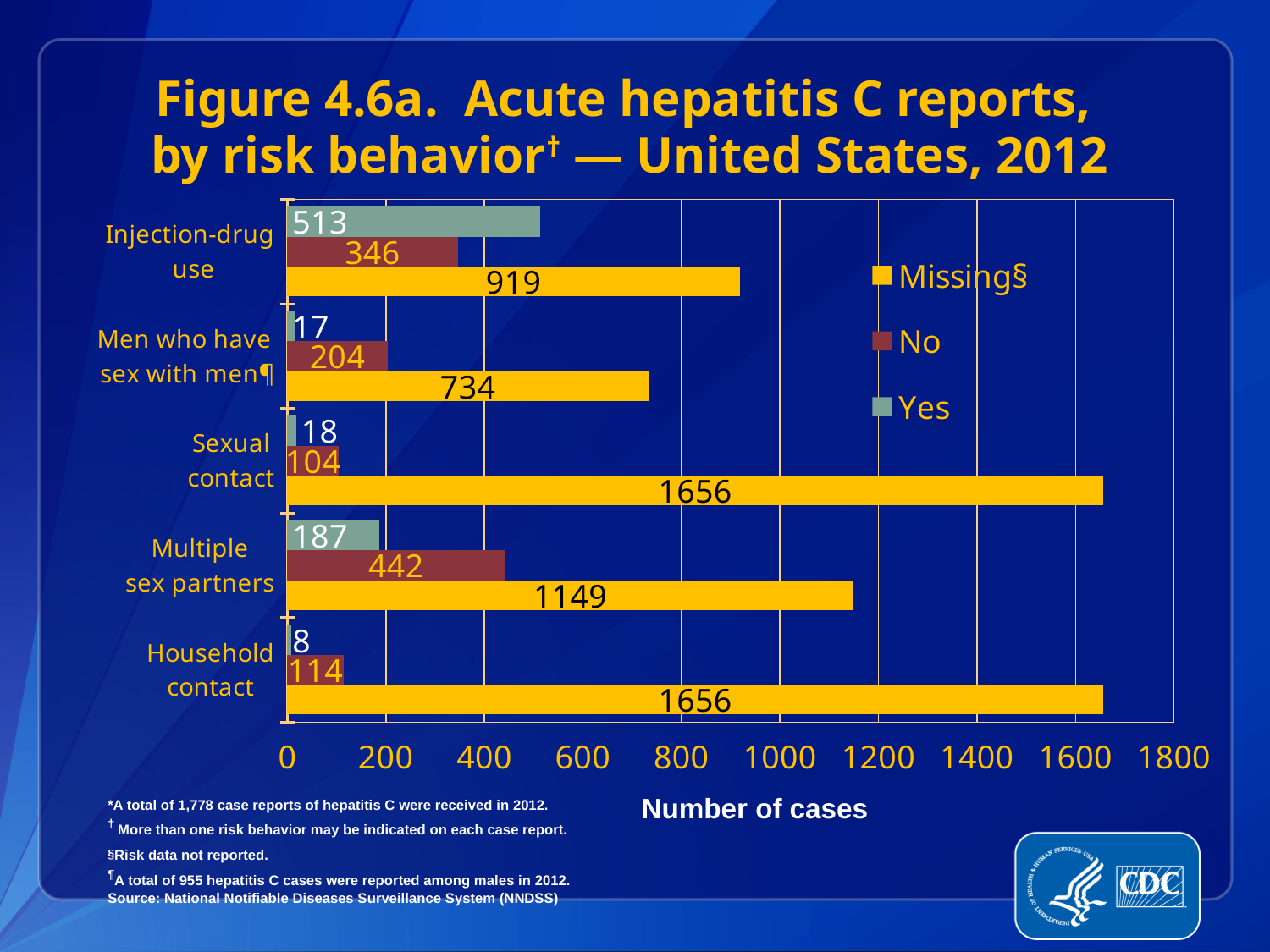
What is the number of cases for Injection-drug use in the Yes series? 513 What is the number of cases for Multiple sex partners in the No series? 442 How many series does the legend list? 3 Which risk behavior has the lowest Yes value? Household contact Which risk behavior has the highest Yes value? Injection-drug use What is the difference between the No values for Multiple sex partners and Injection-drug use? 96 Which is larger, the Missing value for Injection-drug use or the Missing value for Multiple sex partners? Multiple sex partners What is the Missing value for Men who have sex with men? 734 How many risk behavior categories are shown on the chart? 5 What is the label of the x axis? Number of cases What kind of chart is shown on the slide? Bar chart Is the Missing value for Sexual contact greater or less than 1600? greater